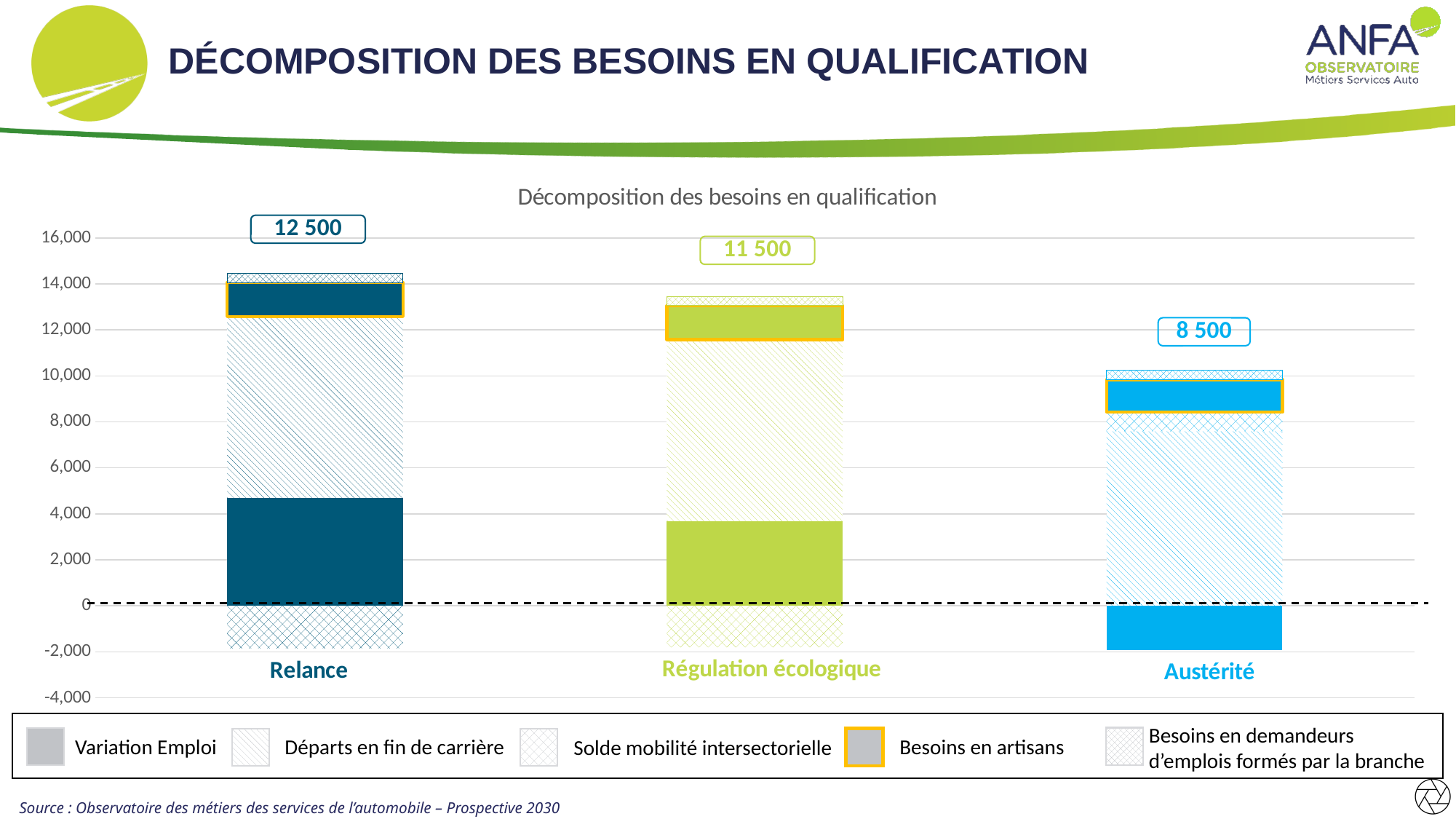
Which scenario has the highest labelled total? Relance What is the labelled total for the Austérité scenario? 8 500 How many series does the legend list? 5 What is the labelled total for the Relance scenario? 12 500 Is the Variation Emploi value for Relance greater or less than 4,000? greater What is the labelled total for the Régulation écologique scenario? 11 500 Which has a larger labelled total, Régulation écologique or Austérité? Régulation écologique How many scenarios are shown on the x axis? 3 What is the difference between the labelled totals for Relance and Régulation écologique? 1 000 What is the difference between the labelled totals for Relance and Austérité? 4 000 Which scenario has the lowest labelled total? Austérité What kind of chart is shown on the slide? Stacked bar chart